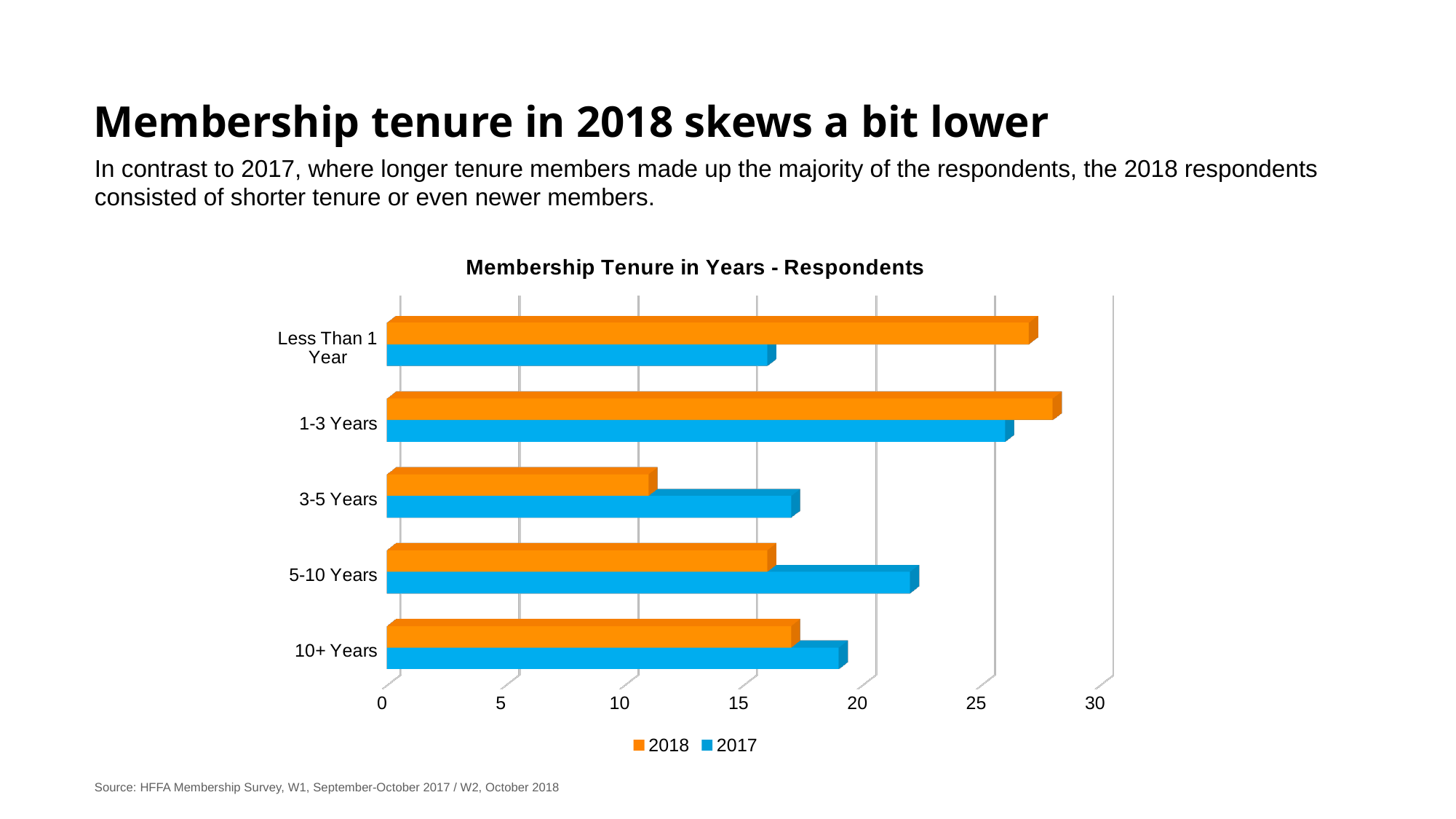
Which colour represents the 2018 series? Orange For 5-10 Years, which series has the larger value, 2018 or 2017? 2017 Is the 2018 value for 1-3 Years greater or less than 25? greater What is the title of the chart? Membership Tenure in Years - Respondents How many tenure categories are shown on the chart? 5 For Less Than 1 Year, which series has the larger value, 2018 or 2017? 2018 Is the 2018 value for 3-5 Years greater or less than 15? less Is the 2017 value for 5-10 Years greater or less than 20? greater How many series does the legend list? 2 Which tenure category has the lowest value for 2018? 3-5 Years Which tenure category has the highest value for 2017? 1-3 Years What kind of chart is shown on the slide? Bar chart